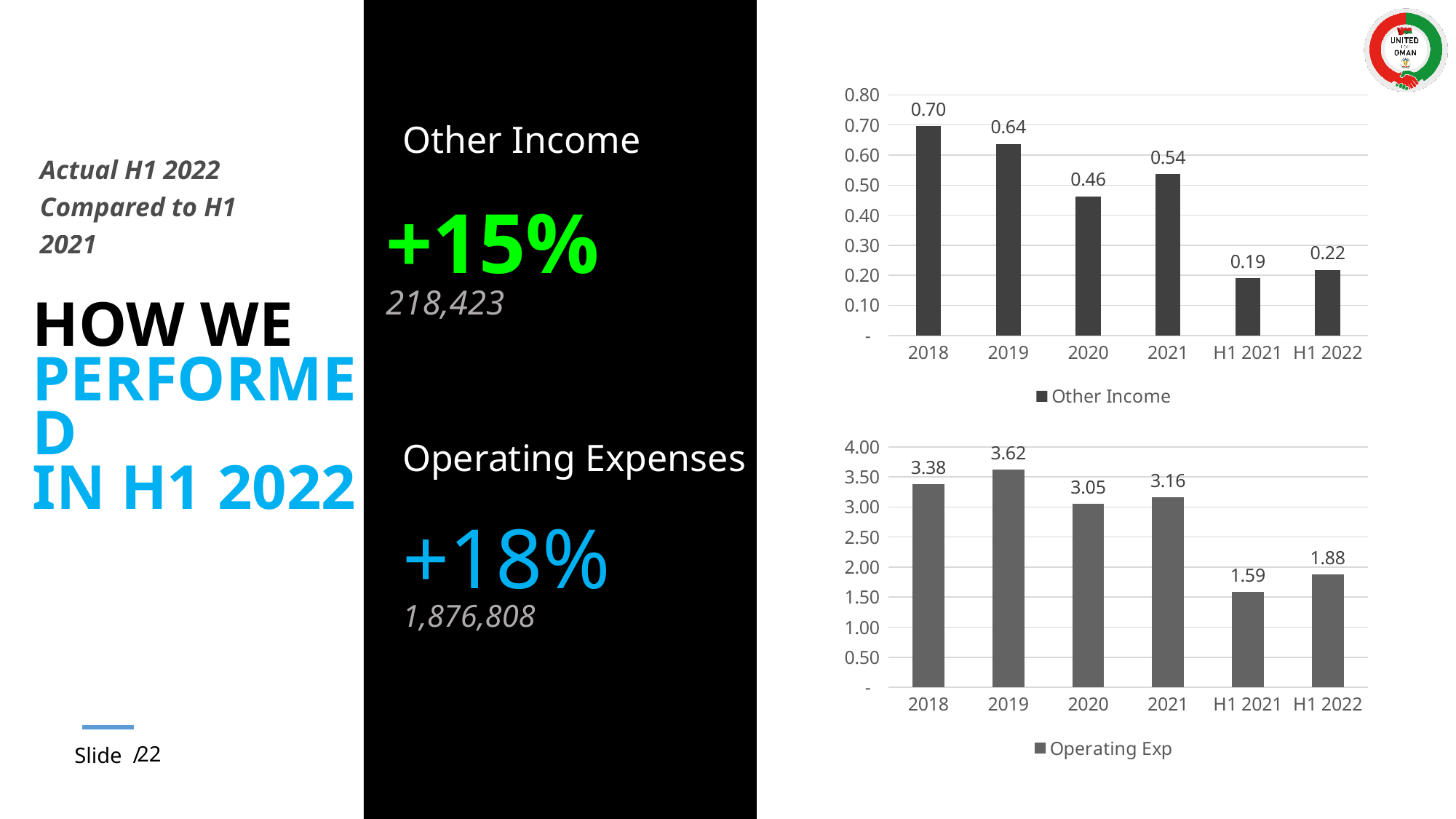
In the Other Income chart, do the values rise or fall from 2018 to 2020? fall In the Operating Exp chart, is the value for 2018 greater or less than 3.00? greater In the Other Income chart, which category has the lowest value? H1 2021 How many series does the legend of the Other Income chart list? 1 In the Operating Exp chart, which is larger, the value for 2020 or the value for 2021? 2021 What kind of chart is the Operating Exp chart? bar chart In the Other Income chart, what is the difference between the 2019 and 2020 values? 0.18 In the Operating Exp chart, what is the difference between the H1 2022 and H1 2021 values? 0.29 In the Other Income chart, what is the value for 2018? 0.70 In the Other Income chart, how many bars are plotted? 6 In the Operating Exp chart, what is the value for H1 2022? 1.88 In the Operating Exp chart, which category has the highest value? 2019